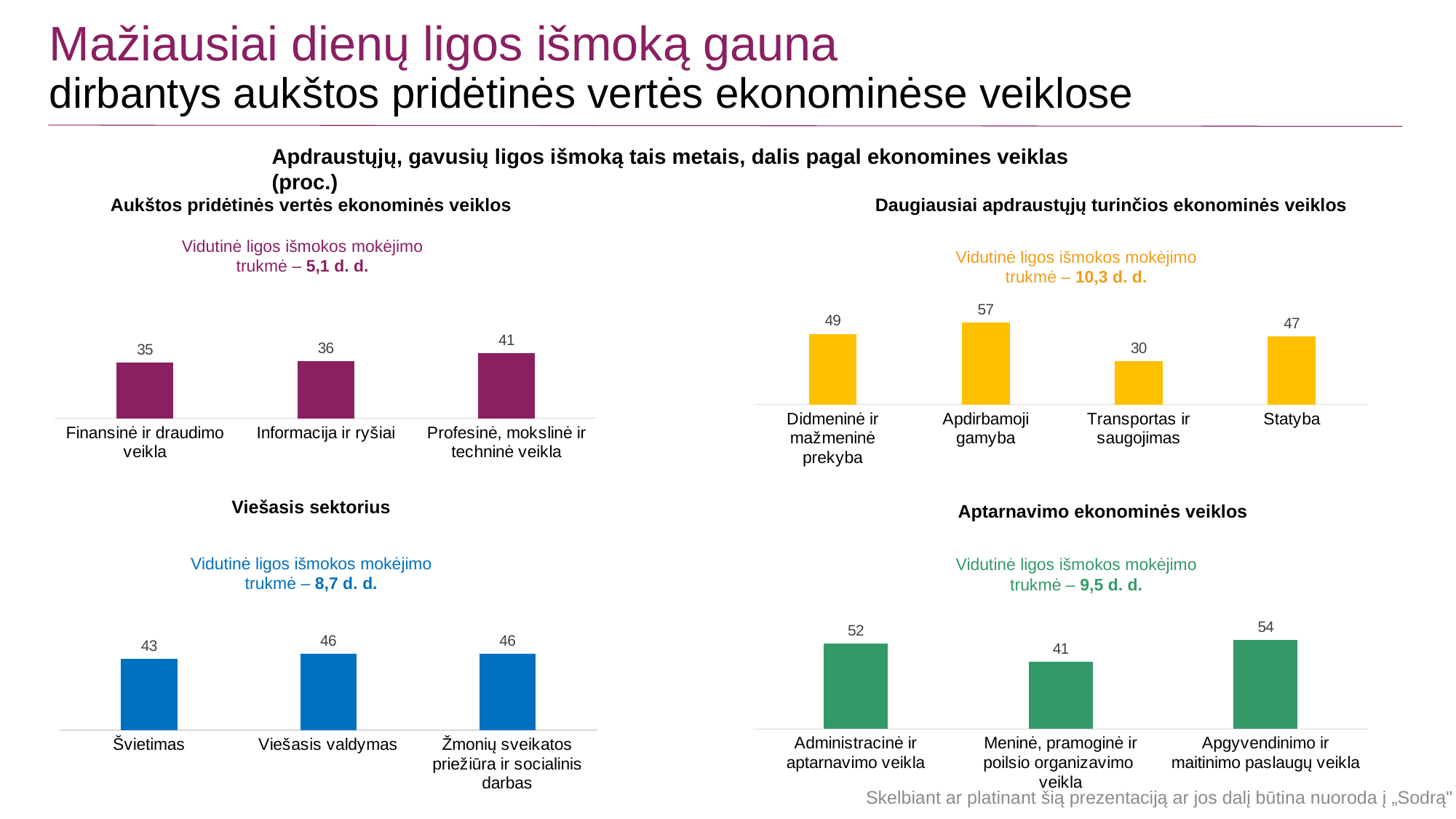
In the chart titled "Daugiausiai apdraustųjų turinčios ekonominės veiklos", what is the value for Transportas ir saugojimas? 30 In the chart titled "Viešasis sektorius", what is the value for Švietimas? 43 In the chart titled "Aukštos pridėtinės vertės ekonominės veiklos", which category has the lowest value? Finansinė ir draudimo veikla In the chart titled "Aukštos pridėtinės vertės ekonominės veiklos", what is the value for Profesinė, mokslinė ir techninė veikla? 41 What average sick-pay duration is stated above the chart titled "Aukštos pridėtinės vertės ekonominės veiklos"? 5,1 d. d. In the chart titled "Daugiausiai apdraustųjų turinčios ekonominės veiklos", which category has the highest value? Apdirbamoji gamyba In the chart titled "Viešasis sektorius", what is the difference between Viešasis valdymas and Švietimas? 3 What kind of chart is the one titled "Viešasis sektorius"? Bar chart In the chart titled "Aptarnavimo ekonominės veiklos", what is the value for Apgyvendinimo ir maitinimo paslaugų veikla? 54 In the chart titled "Aptarnavimo ekonominės veiklos", which is larger: Administracinė ir aptarnavimo veikla or Meninė, pramoginė ir poilsio organizavimo veikla? Administracinė ir aptarnavimo veikla In the chart titled "Daugiausiai apdraustųjų turinčios ekonominės veiklos", how many categories are shown? 4 In the chart titled "Daugiausiai apdraustųjų turinčios ekonominės veiklos", what is the difference between Apdirbamoji gamyba and Statyba? 10